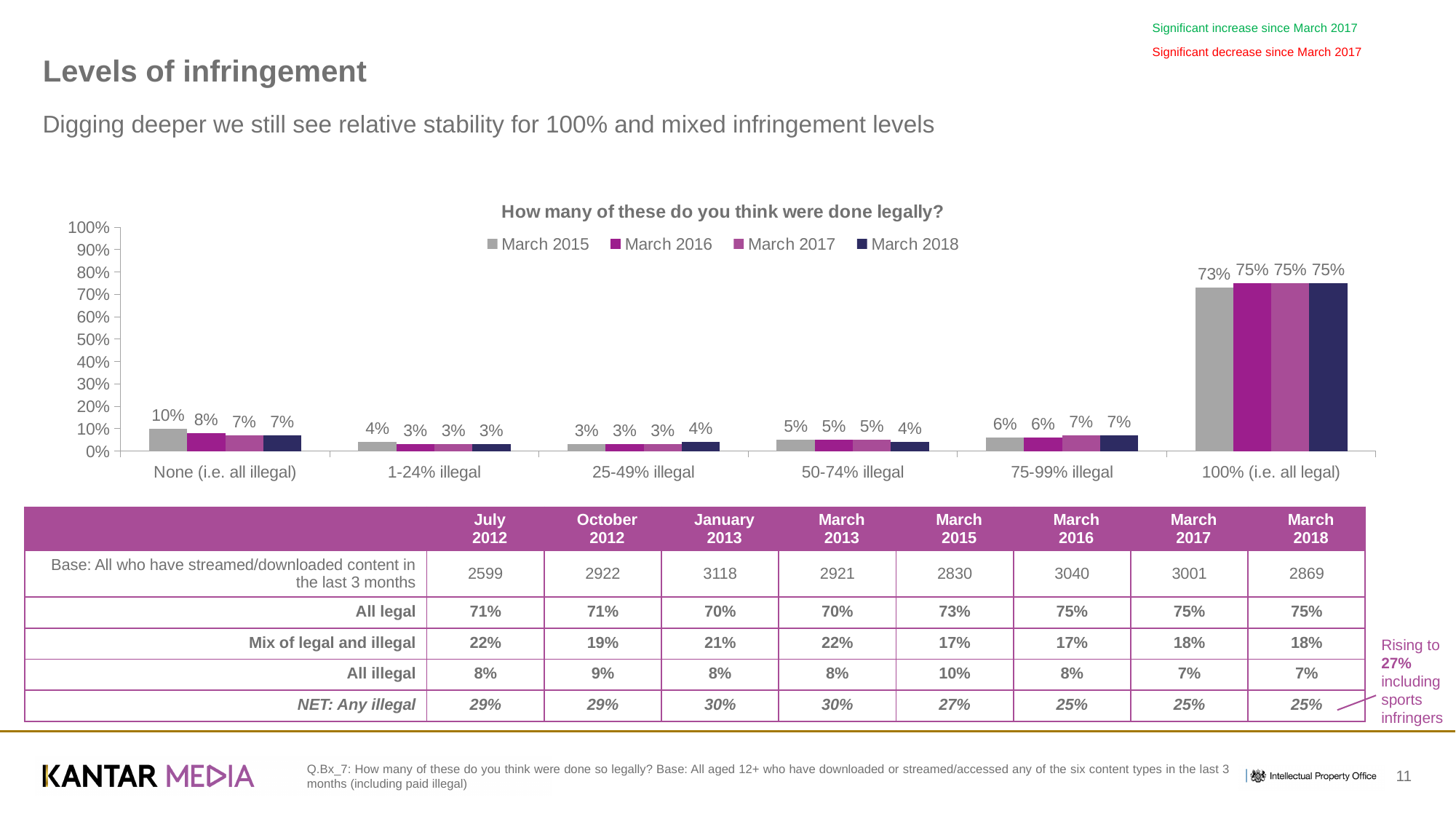
What is the March 2015 value for the 'None (i.e. all illegal)' category? 10% What is the March 2018 value for the '50-74% illegal' category? 4% Which category has the highest value for March 2016? 100% (i.e. all legal) What is the title of the chart? How many of these do you think were done legally? What is the difference between the March 2015 and March 2018 values for the '100% (i.e. all legal)' category? 2% What is the difference between the March 2015 and March 2017 values for the 'None (i.e. all illegal)' category? 3% How many series does the chart legend list? 4 What is the March 2018 value for the '100% (i.e. all legal)' category? 75% What is the March 2017 value for the '75-99% illegal' category? 7% How many categories are shown on the x axis of the chart? 6 Which is larger for March 2015: the value for 'None (i.e. all illegal)' or the value for '1-24% illegal'? None (i.e. all illegal) What kind of chart is shown on the slide? Bar chart